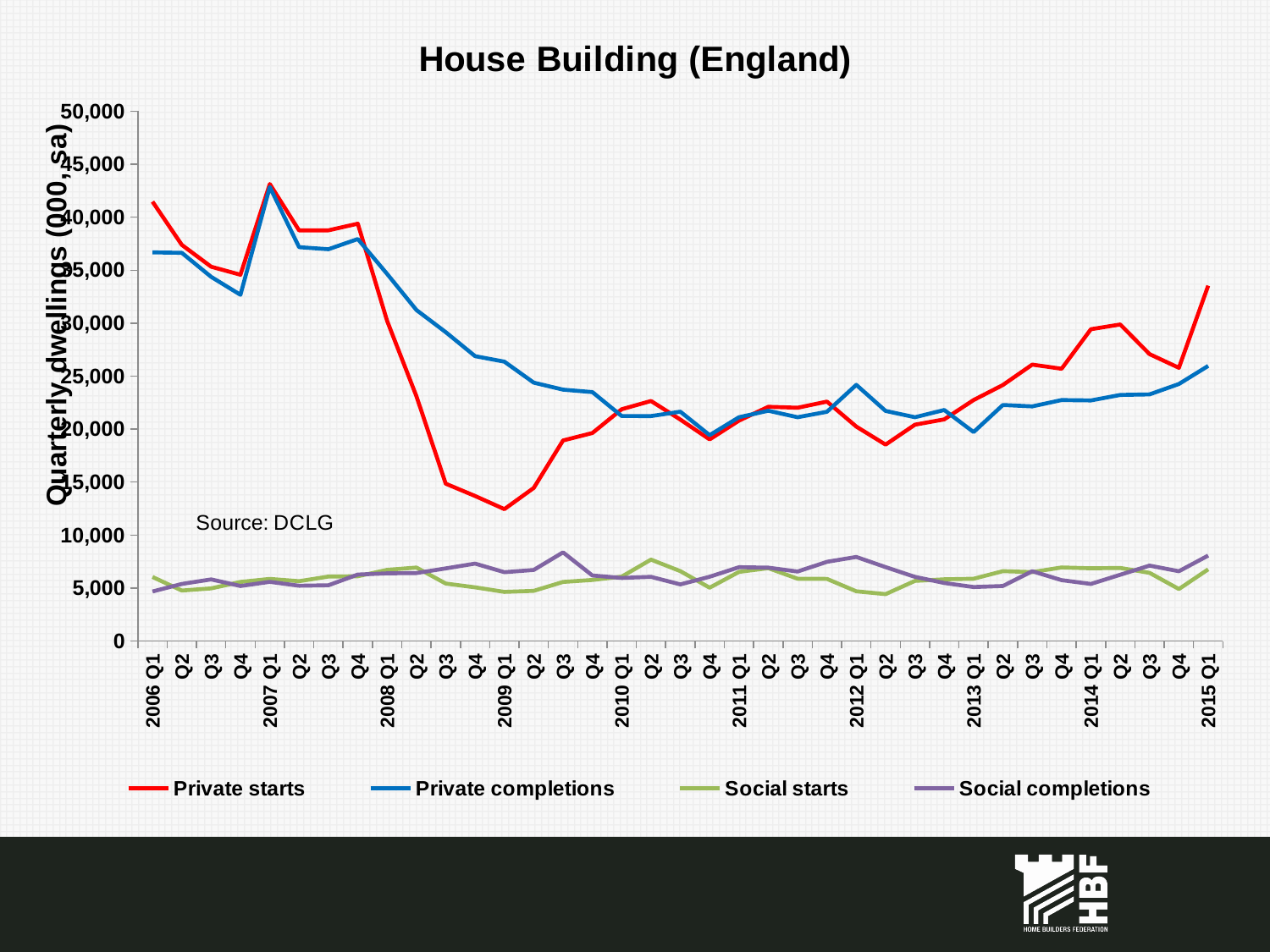
Is the value for Private starts in 2006 Q1 greater or less than 40,000? greater Is the value for Private starts in 2009 Q1 greater or less than 15,000? less In which quarter do Private starts reach their highest value? 2007 Q1 Is the value for Private completions in 2015 Q1 greater or less than 25,000? greater Do Private starts rise or fall between 2008 Q1 and 2009 Q1? Fall In which quarter do Private starts reach their lowest value? 2009 Q1 How many quarters are plotted along the x axis, from 2006 Q1 to 2015 Q1? 37 How many series does the legend list? 4 What is the title of the chart? House Building (England) In 2015 Q1, which is larger: Private starts or Private completions? Private starts In 2009 Q1, which is larger: Private starts or Private completions? Private completions What kind of chart is shown on the slide? Line chart